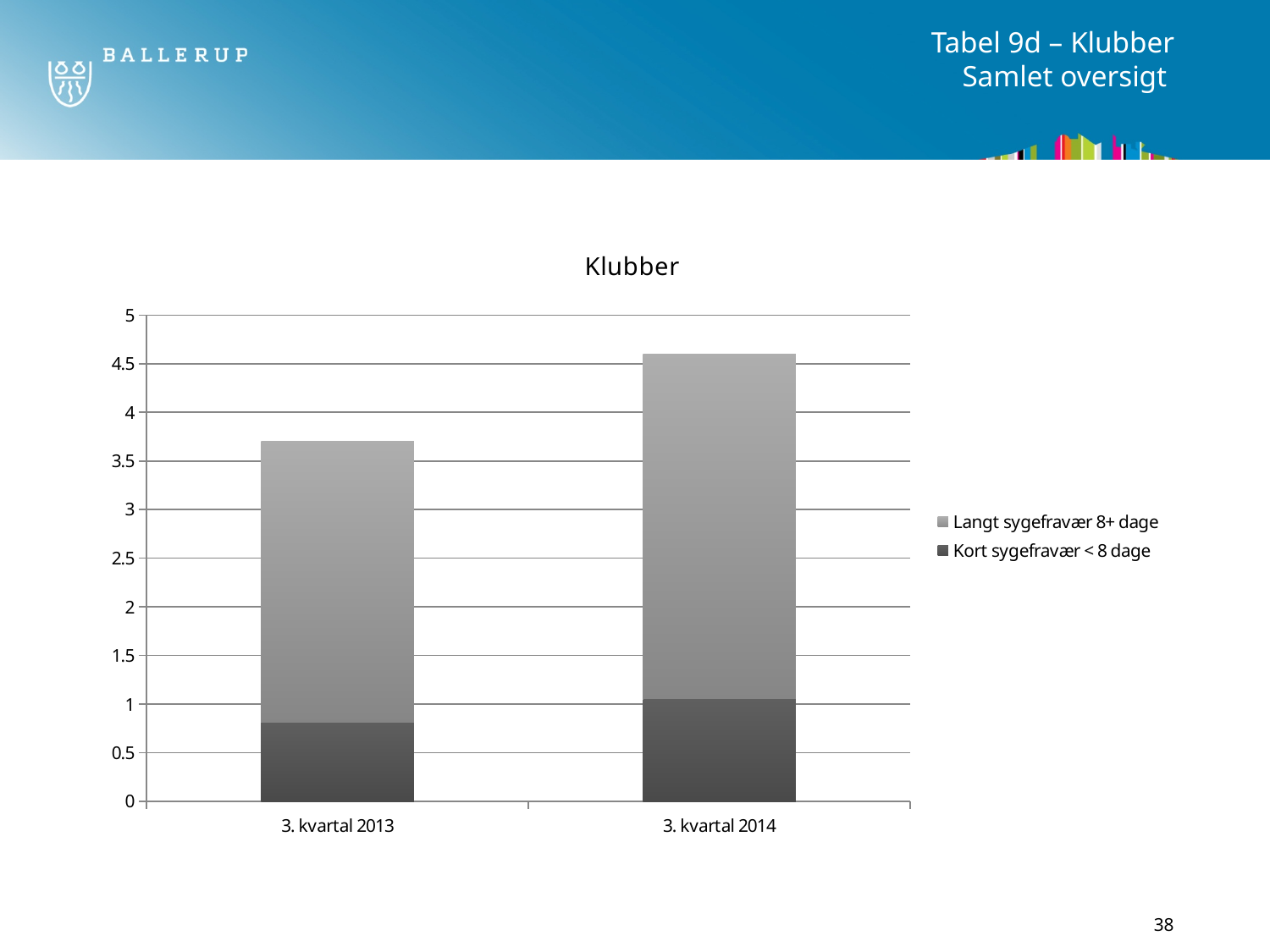
Which category has the taller stacked bar, 3. kvartal 2013 or 3. kvartal 2014? 3. kvartal 2014 What kind of chart is shown on the slide? stacked bar chart Which category has the shorter stacked bar? 3. kvartal 2013 Does the total stacked value rise or fall from 3. kvartal 2013 to 3. kvartal 2014? rise Is the total stacked value for 3. kvartal 2014 greater or less than 4? greater Is the value of Kort sygefravær < 8 dage for 3. kvartal 2014 greater or less than 1.5? less Is the total stacked value for 3. kvartal 2013 greater or less than 3.5? greater What is the title of the chart? Klubber How many categories are shown on the x axis? 2 How many series does the legend list? 2 Which series is shown in the darker grey colour? Kort sygefravær < 8 dage